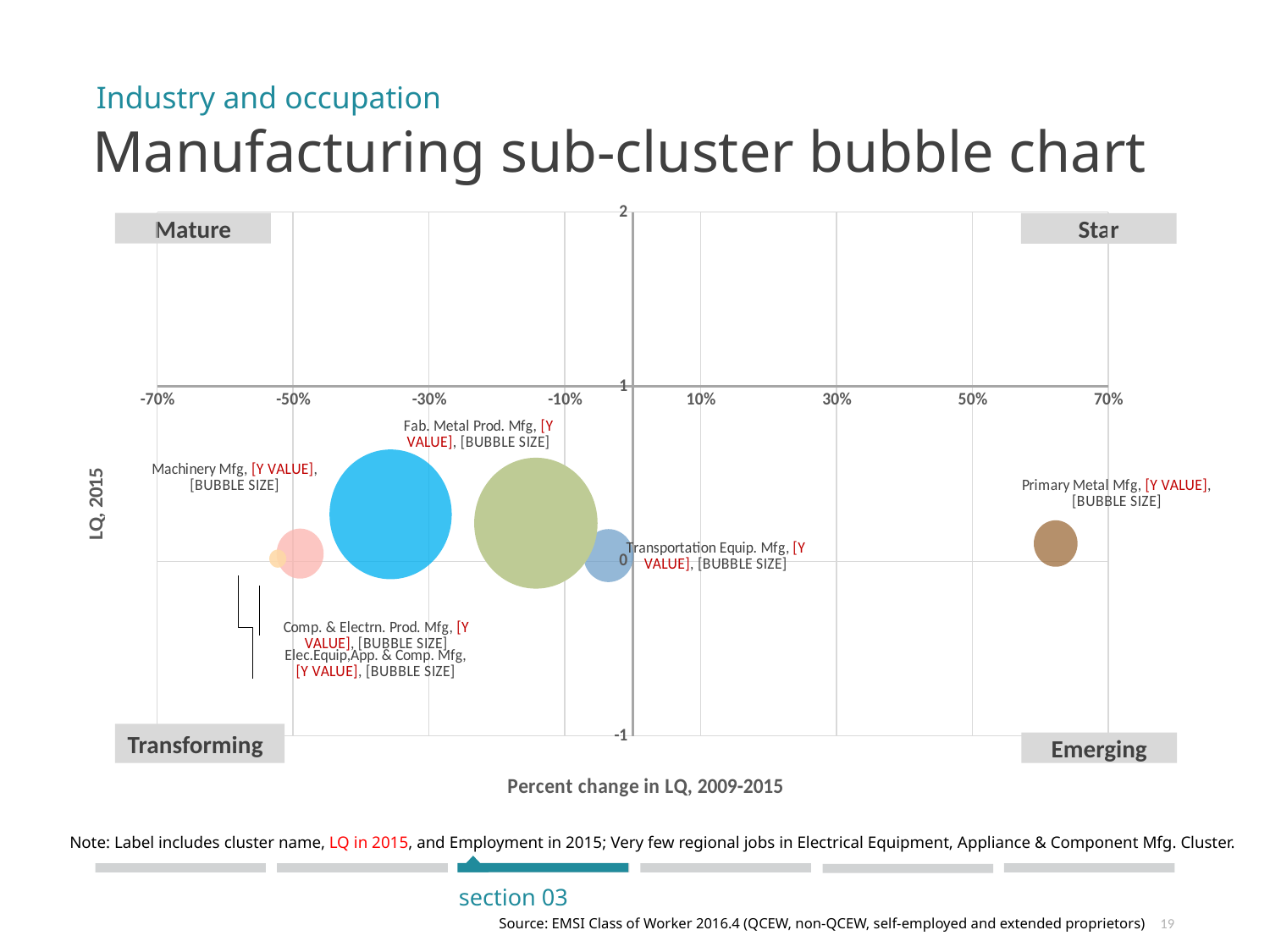
What kind of chart is shown on the slide? Bubble chart Which labeled sub-cluster is plotted furthest to the right on the x axis (highest percent change in LQ)? Primary Metal Mfg Which sub-cluster has a higher percent change in LQ, Transportation Equip. Mfg or Fab. Metal Prod. Mfg? Transportation Equip. Mfg Which sub-cluster has a higher percent change in LQ, Primary Metal Mfg or Machinery Mfg? Primary Metal Mfg Is the percent change in LQ for Fab. Metal Prod. Mfg greater or less than -10%? less Is the percent change in LQ for Primary Metal Mfg greater or less than 50%? greater What is the label of the x axis of the bubble chart? Percent change in LQ, 2009-2015 Is the LQ, 2015 value for Transportation Equip. Mfg greater or less than 1? less Which bubble is larger, Fab. Metal Prod. Mfg or Transportation Equip. Mfg? Fab. Metal Prod. Mfg What is the title of the chart on the slide? Manufacturing sub-cluster bubble chart